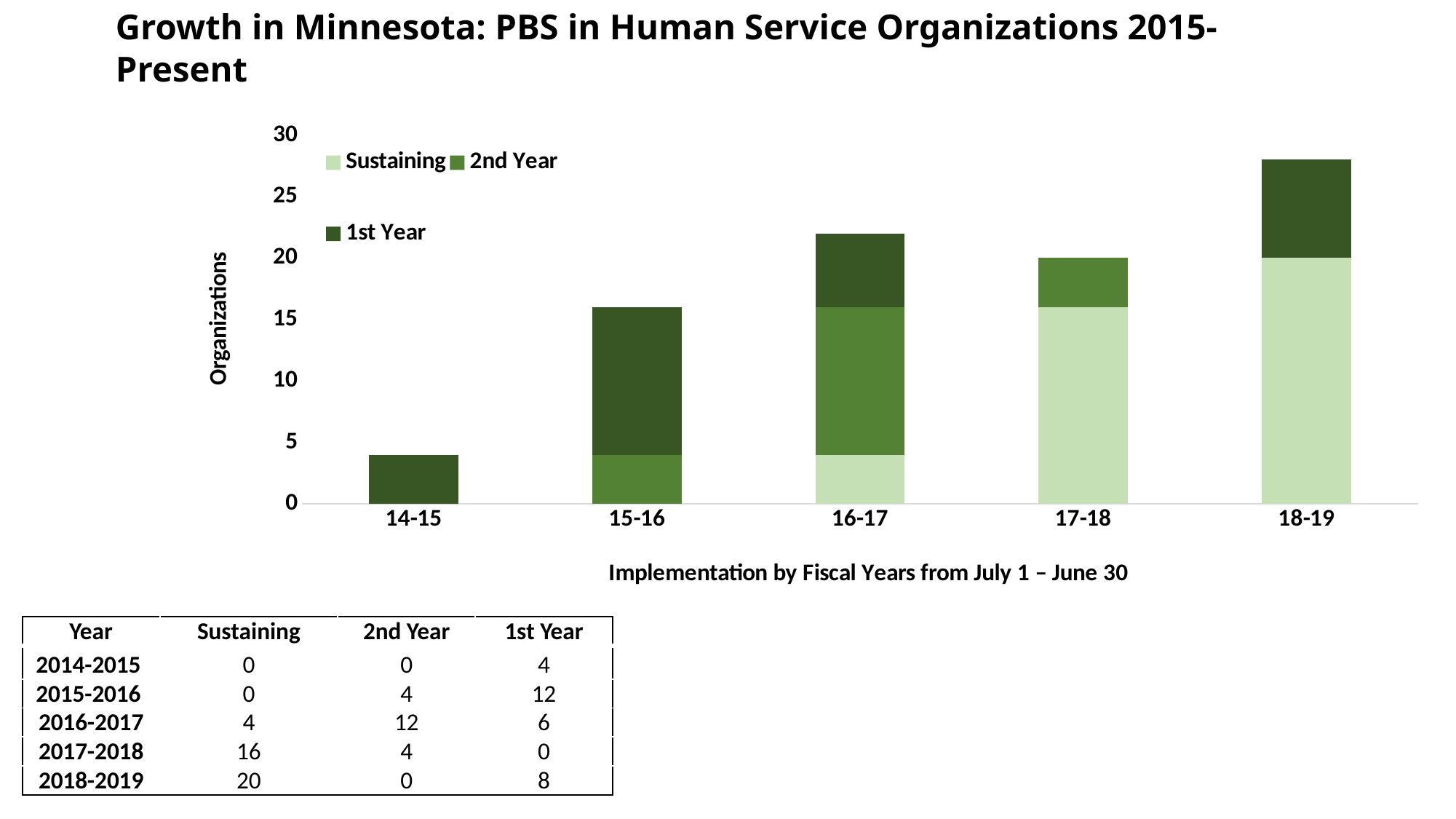
How many fiscal years are shown on the x axis of the chart? 5 What is the 2nd Year value for 2016-2017? 12 What kind of chart is shown on the slide? Stacked bar chart What is the Sustaining value for 2018-2019? 20 What is the total height of the stacked bar for 18-19? 28 What is the total height of the stacked bar for 16-17? 22 What is the difference between the Sustaining values for 2018-2019 and 2017-2018? 4 Which fiscal year has the tallest stacked bar? 18-19 What is the 1st Year value for 2015-2016? 12 Is the total for 15-16 greater or less than 20? less How many series does the chart legend list? 3 Which fiscal year has the shortest stacked bar? 14-15